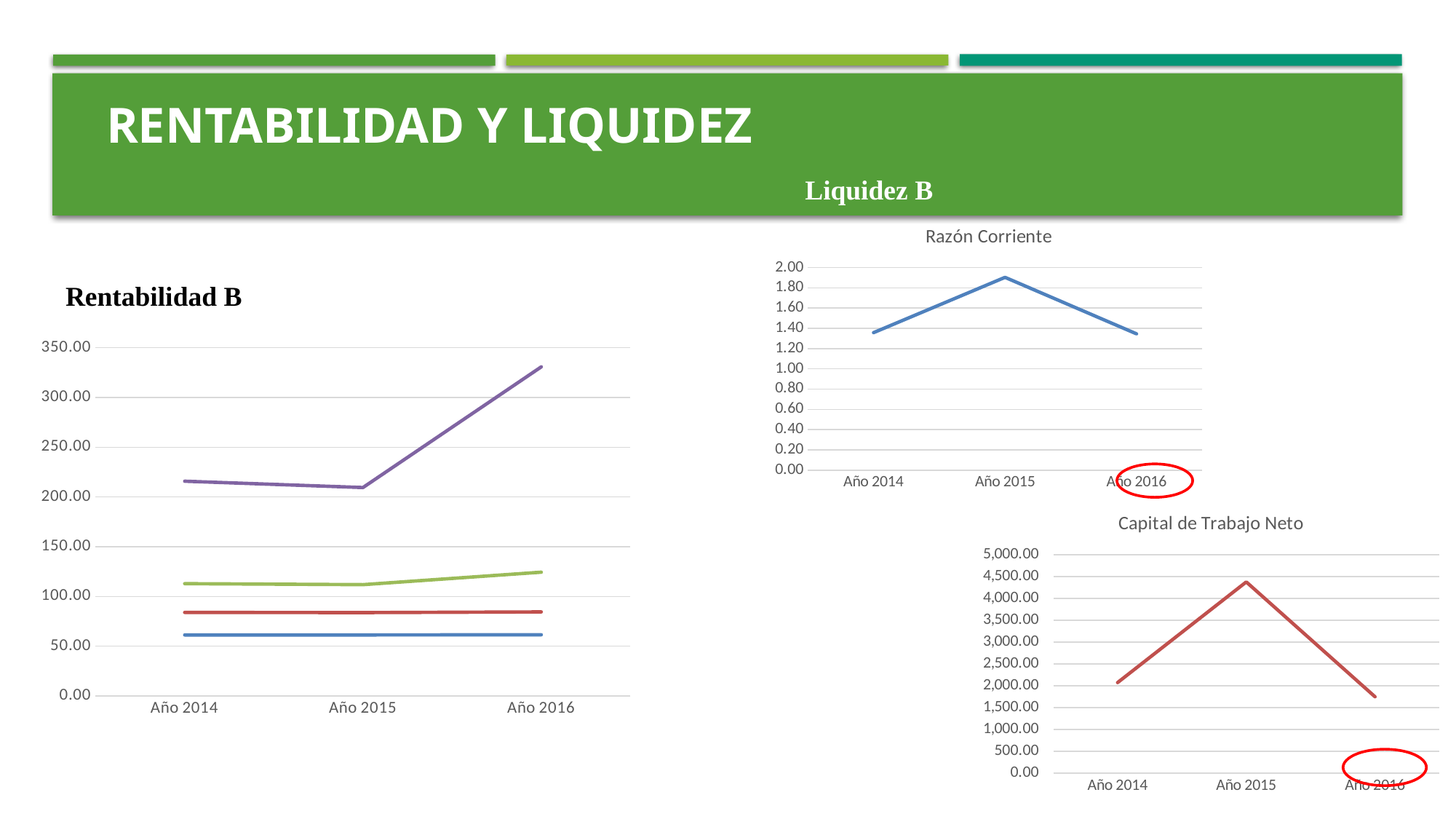
In the "Capital de Trabajo Neto" chart, which year has the lowest value? Año 2016 In the "Capital de Trabajo Neto" chart, is the value for Año 2016 greater or less than 2,000.00? less In the "Razón Corriente" chart, is the value for Año 2014 greater or less than 1.60? less How many years are plotted on the x axis of the "Capital de Trabajo Neto" chart? 3 In the "Razón Corriente" chart, is the value for Año 2015 greater or less than 1.80? greater In the "Capital de Trabajo Neto" chart, which year has the highest value? Año 2015 In the "Razón Corriente" chart, which year has the highest value? Año 2015 In the "Rentabilidad B" chart, does the purple line rise or fall from Año 2015 to Año 2016? rise How many lines are plotted in the "Rentabilidad B" chart? 4 What kind of chart is the "Razón Corriente" chart? line chart